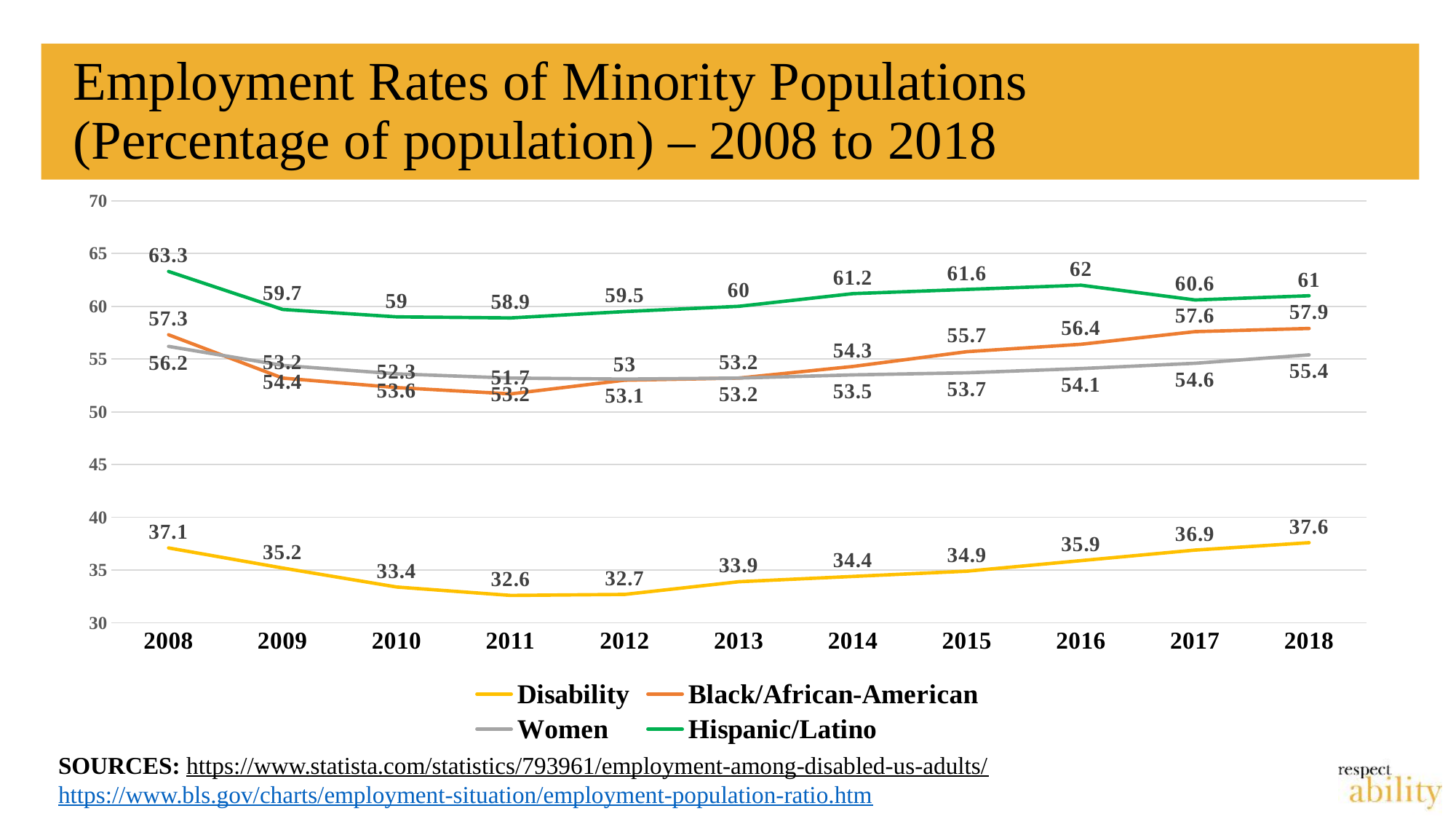
How many series does the legend list? 4 What type of chart is shown on the slide? Line chart Which series has the higher value in 2008, Black/African-American or Women? Black/African-American Does the Disability series rise or fall from 2011 to 2018? Rise In which year is the Disability series at its lowest? 2011 How many years are plotted along the x axis? 11 What is the difference between the Hispanic/Latino and Disability values in 2018? 23.4 What is the employment rate for the Women series in 2018? 55.4 What is the employment rate for the Black/African-American series in 2018? 57.9 What is the employment rate for the Disability series in 2011? 32.6 What is the employment rate for the Hispanic/Latino series in 2008? 63.3 In which year is the Hispanic/Latino series at its highest? 2008